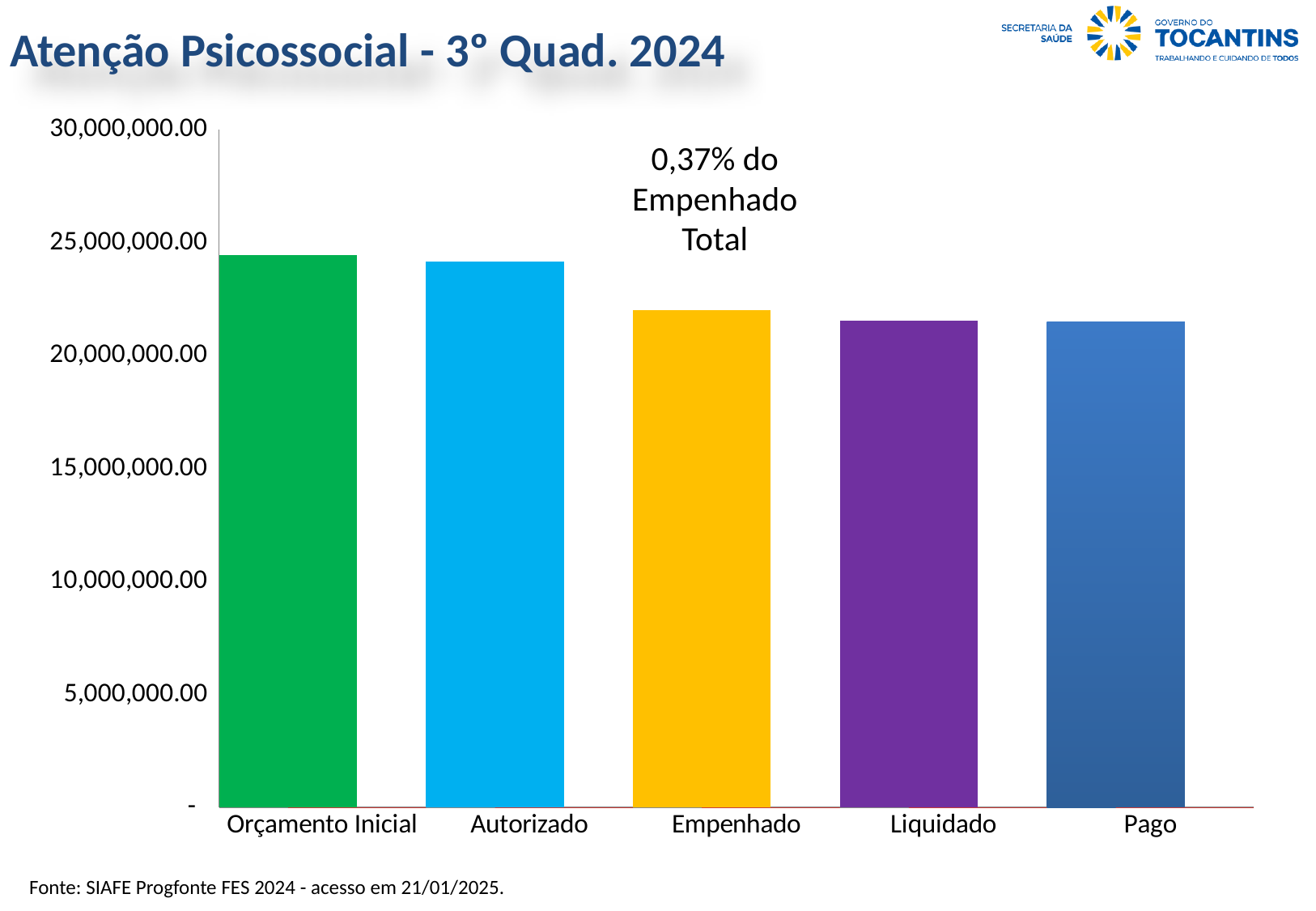
Is the value for Autorizado greater or less than 25,000,000.00? less How many categories are shown on the x axis of the chart? 5 What percentage annotation is printed above the Empenhado bar? 0,37% do Empenhado Total What kind of chart is shown on the slide? bar chart Which is larger, the value for Orçamento Inicial or the value for Empenhado? Orçamento Inicial Is the value for Liquidado greater or less than 25,000,000.00? less Which is larger, the value for Autorizado or the value for Pago? Autorizado Is the value for Pago greater or less than 20,000,000.00? greater What is the title of the slide containing the chart? Atenção Psicossocial - 3º Quad. 2024 Do the bar values generally rise or fall from left to right along the x axis? fall